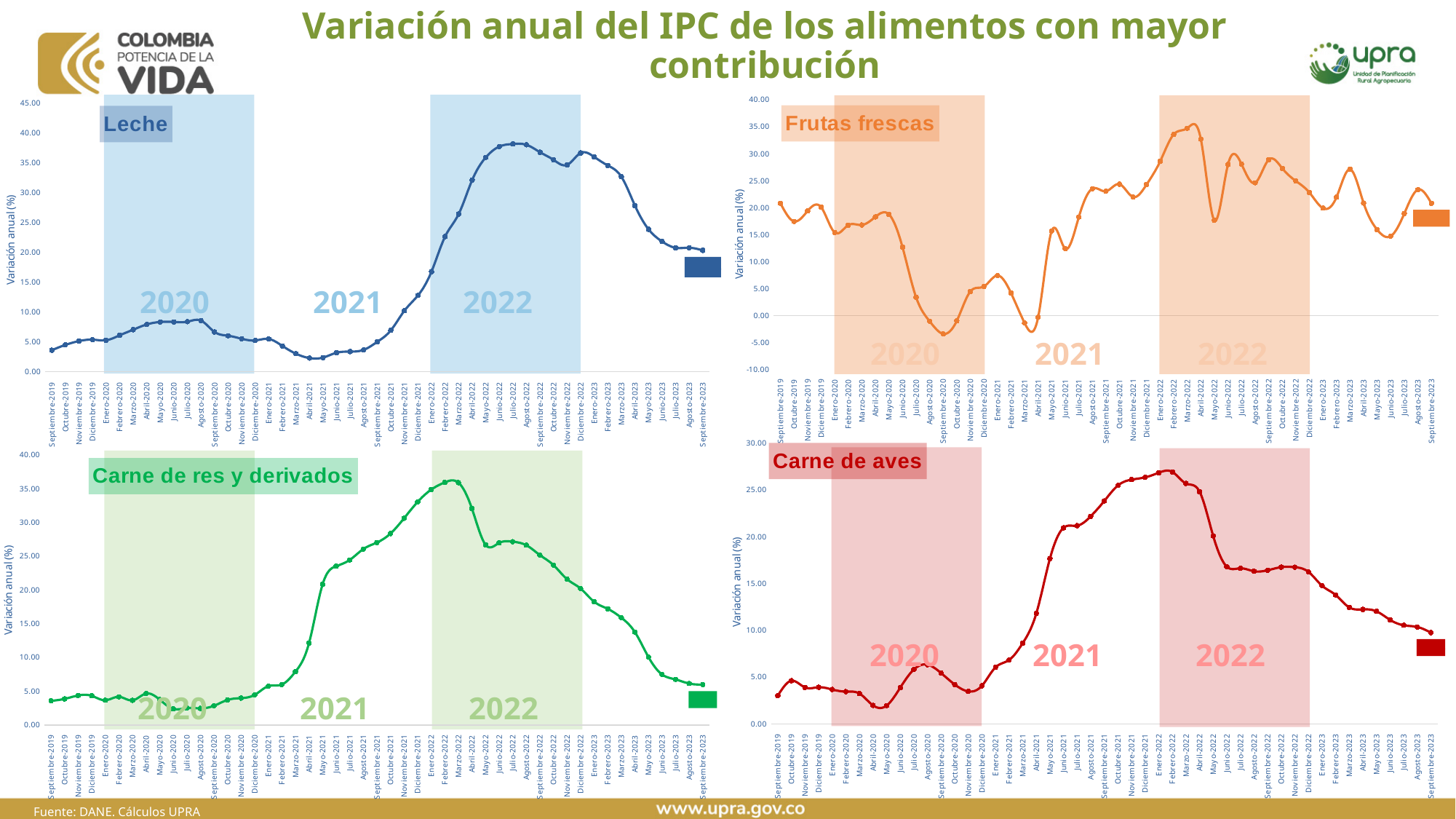
What kind of chart is the 'Leche' chart? line chart In the 'Carne de res y derivados' chart, do the values rise or fall from Abril-2022 to Septiembre-2023? fall In the 'Leche' chart, is the value for Abril-2021 greater or less than 5.00? less In the 'Frutas frescas' chart, is the value for Septiembre-2020 greater or less than 0.00? less In the 'Frutas frescas' chart, is the value for Abril-2022 greater or less than 30.00? greater What is the label on the vertical axis of the 'Carne de aves' chart? Variación anual (%) In the 'Leche' chart, which is larger, the value for Septiembre-2019 or the value for Septiembre-2023? Septiembre-2023 How many charts are shown on the slide? 4 In the 'Carne de aves' chart, do the values rise or fall from Diciembre-2020 to Mayo-2021? rise